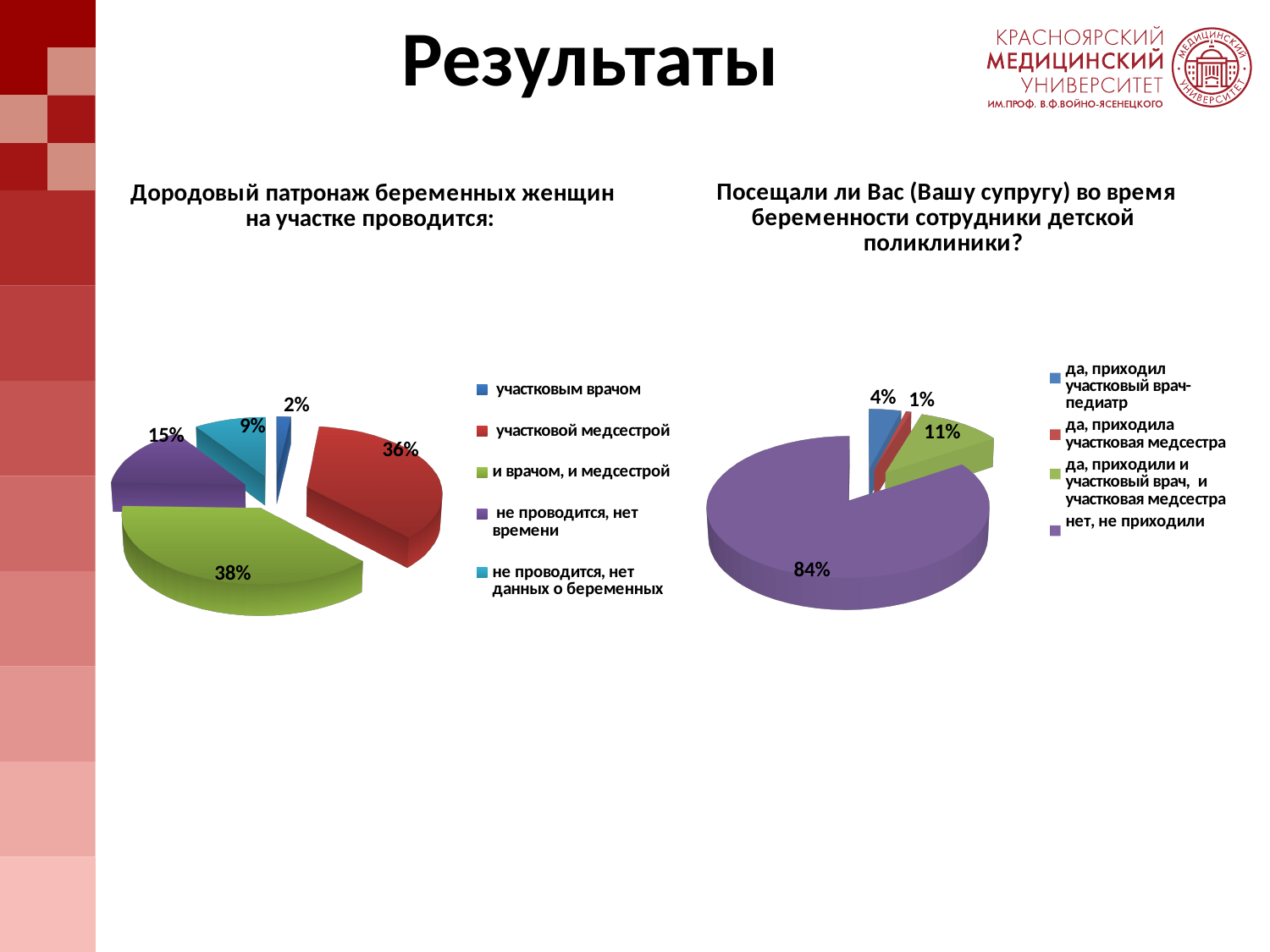
In the left chart 'Дородовый патронаж беременных женщин на участке проводится:', what share is labelled for 'и врачом, и медсестрой'? 38% In the left chart 'Дородовый патронаж беременных женщин на участке проводится:', what share is labelled for 'не проводится, нет данных о беременных'? 9% In the left chart 'Дородовый патронаж беременных женщин на участке проводится:', how many categories does the legend list? 5 What kind of chart is the left chart 'Дородовый патронаж беременных женщин на участке проводится:'? pie chart In the left chart 'Дородовый патронаж беременных женщин на участке проводится:', which category has the smallest share? участковым врачом In the right chart 'Посещали ли Вас (Вашу супругу) во время беременности сотрудники детской поликлиники?', what share is labelled for 'да, приходила участковая медсестра'? 1% In the right chart 'Посещали ли Вас (Вашу супругу) во время беременности сотрудники детской поликлиники?', which category has the largest share? нет, не приходили In the left chart 'Дородовый патронаж беременных женщин на участке проводится:', what is the difference between the shares for 'не проводится, нет времени' and 'не проводится, нет данных о беременных'? 6% In the right chart 'Посещали ли Вас (Вашу супругу) во время беременности сотрудники детской поликлиники?', what share is labelled for 'нет, не приходили'? 84% In the right chart 'Посещали ли Вас (Вашу супругу) во время беременности сотрудники детской поликлиники?', what colour is the slice for 'нет, не приходили'? purple In the right chart 'Посещали ли Вас (Вашу супругу) во время беременности сотрудники детской поликлиники?', which is larger: the share for 'да, приходил участковый врач-педиатр' or for 'да, приходили и участковый врач, и участковая медсестра'? да, приходили и участковый врач, и участковая медсестра In the left chart 'Дородовый патронаж беременных женщин на участке проводится:', what share is labelled for 'участковой медсестрой'? 36%